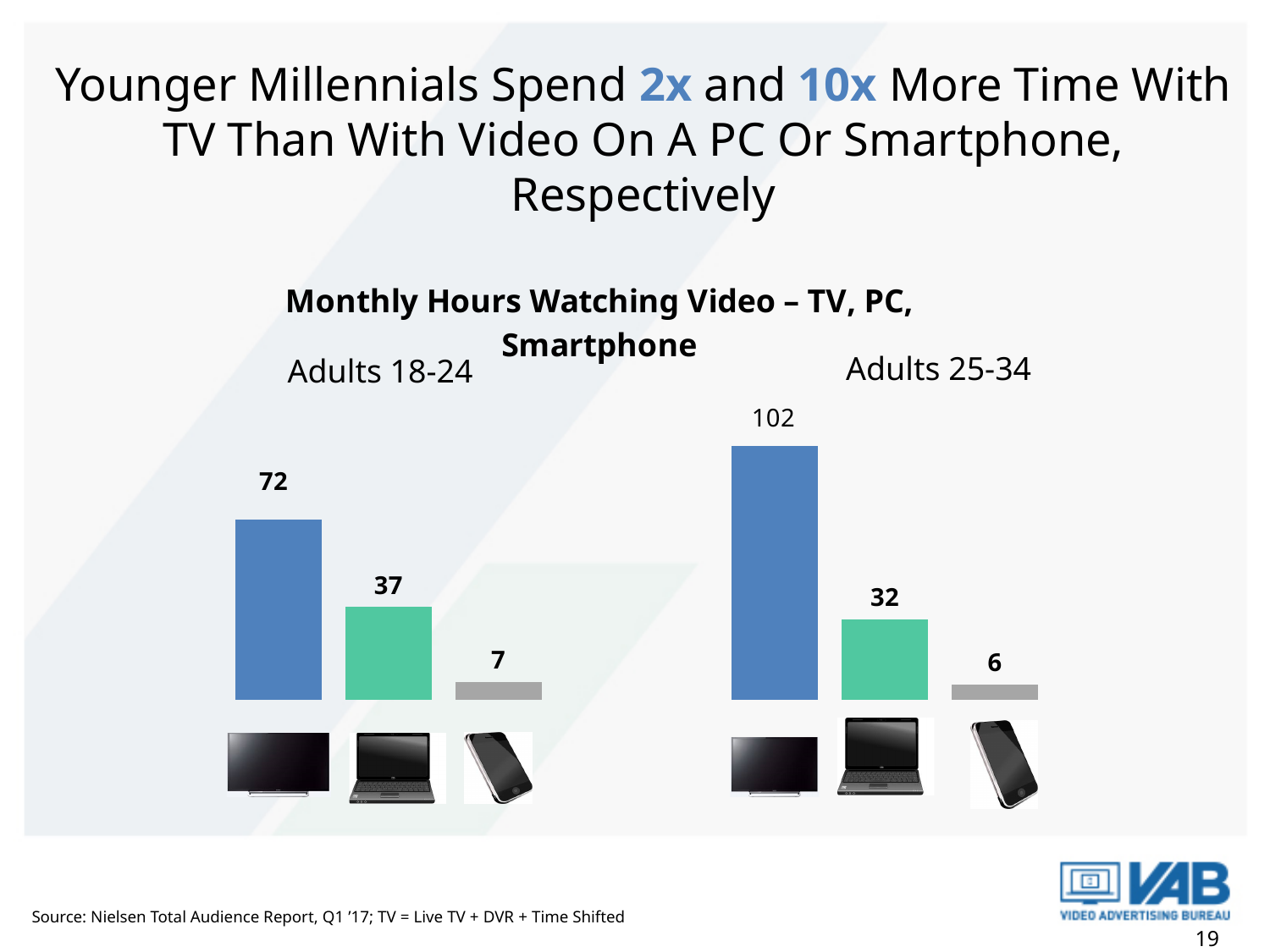
In the Adults 18-24 chart, which device has the highest monthly hours? TV In the Adults 25-34 chart, how many monthly hours are spent watching video on a smartphone? 6 How many bars are in the Adults 18-24 chart? 3 In the Adults 25-34 chart, which device has the lowest monthly hours? Smartphone Which is larger: the TV value for Adults 18-24 or the TV value for Adults 25-34? Adults 25-34 In the Adults 18-24 chart, how many monthly hours are spent watching video on TV? 72 What kind of chart is used to show the monthly hours for Adults 25-34? Bar chart In the Adults 25-34 chart, what is the difference between the TV and smartphone values? 96 In the Adults 18-24 chart, what is the difference between the TV and PC values? 35 What is the title shown above the two charts? Monthly Hours Watching Video – TV, PC, Smartphone Which is larger: the PC value for Adults 18-24 or the PC value for Adults 25-34? Adults 18-24 In the Adults 25-34 chart, what is the value for PC? 32